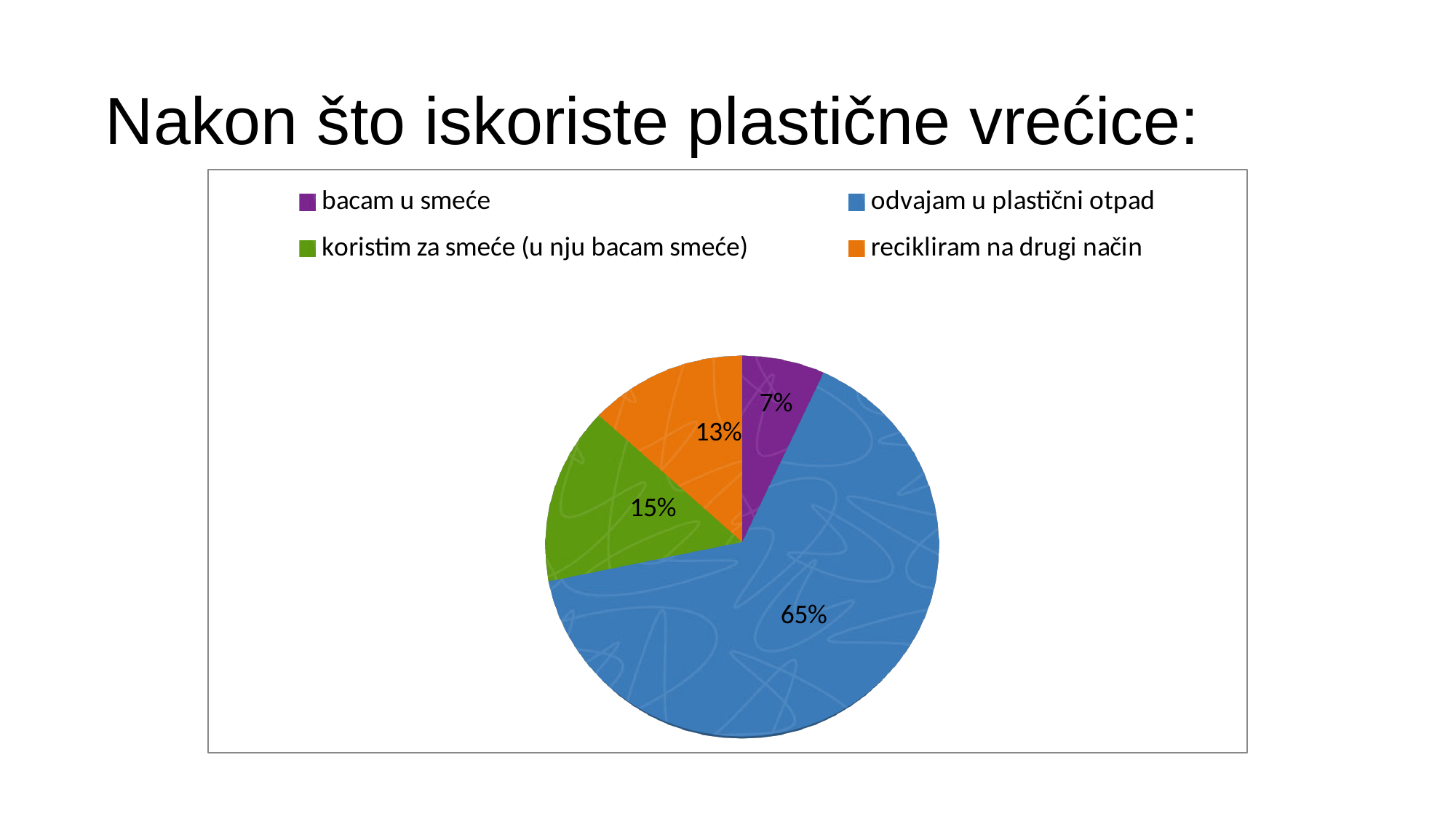
Which category has the smallest slice of the pie? bacam u smeće What is the title of the slide above the chart? Nakon što iskoriste plastične vrećice: What colour is the slice for "recikliram na drugi način"? orange What is the difference in percentage points between "odvajam u plastični otpad" and "koristim za smeće (u nju bacam smeće)"? 50 How many categories does the pie chart have? 4 What share of the pie does "recikliram na drugi način" have? 13% What share of the pie does "koristim za smeće (u nju bacam smeće)" have? 15% Which is larger: the slice for "koristim za smeće (u nju bacam smeće)" or the slice for "recikliram na drugi način"? koristim za smeće (u nju bacam smeće) What share of the pie does "bacam u smeće" have? 7% Which category has the largest slice of the pie? odvajam u plastični otpad What kind of chart is shown on the slide? pie chart